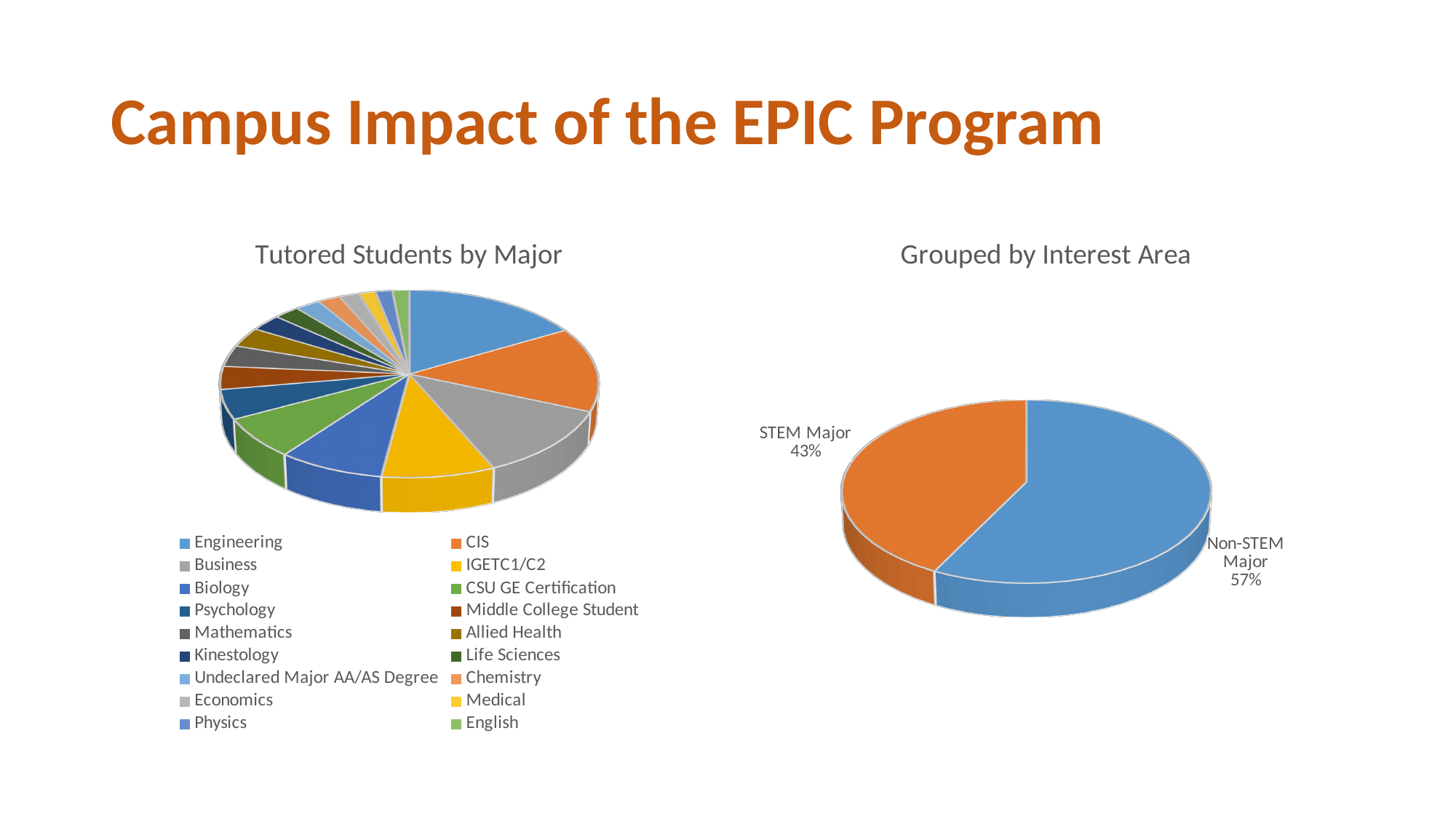
How many slices does the 'Grouped by Interest Area' chart have? 2 In the 'Grouped by Interest Area' chart, what do the two labelled percentages add up to? 100% What kind of chart is the 'Grouped by Interest Area' chart? Pie chart In the 'Tutored Students by Major' chart, which slice is larger, Engineering or Business? Engineering In the 'Grouped by Interest Area' chart, what share of students are Non-STEM Majors? 57% In the 'Grouped by Interest Area' chart, which slice is larger, STEM Major or Non-STEM Major? Non-STEM Major In the 'Grouped by Interest Area' chart, what percentage is labelled for STEM Major? 43% In the 'Tutored Students by Major' chart, which slice is larger, CIS or Biology? CIS What is the title of the pie chart on the left of the slide? Tutored Students by Major How many majors are listed in the legend of the 'Tutored Students by Major' chart? 18 In the 'Grouped by Interest Area' chart, what is the difference in percentage points between Non-STEM Major and STEM Major? 14% What kind of chart is the 'Tutored Students by Major' chart? Pie chart